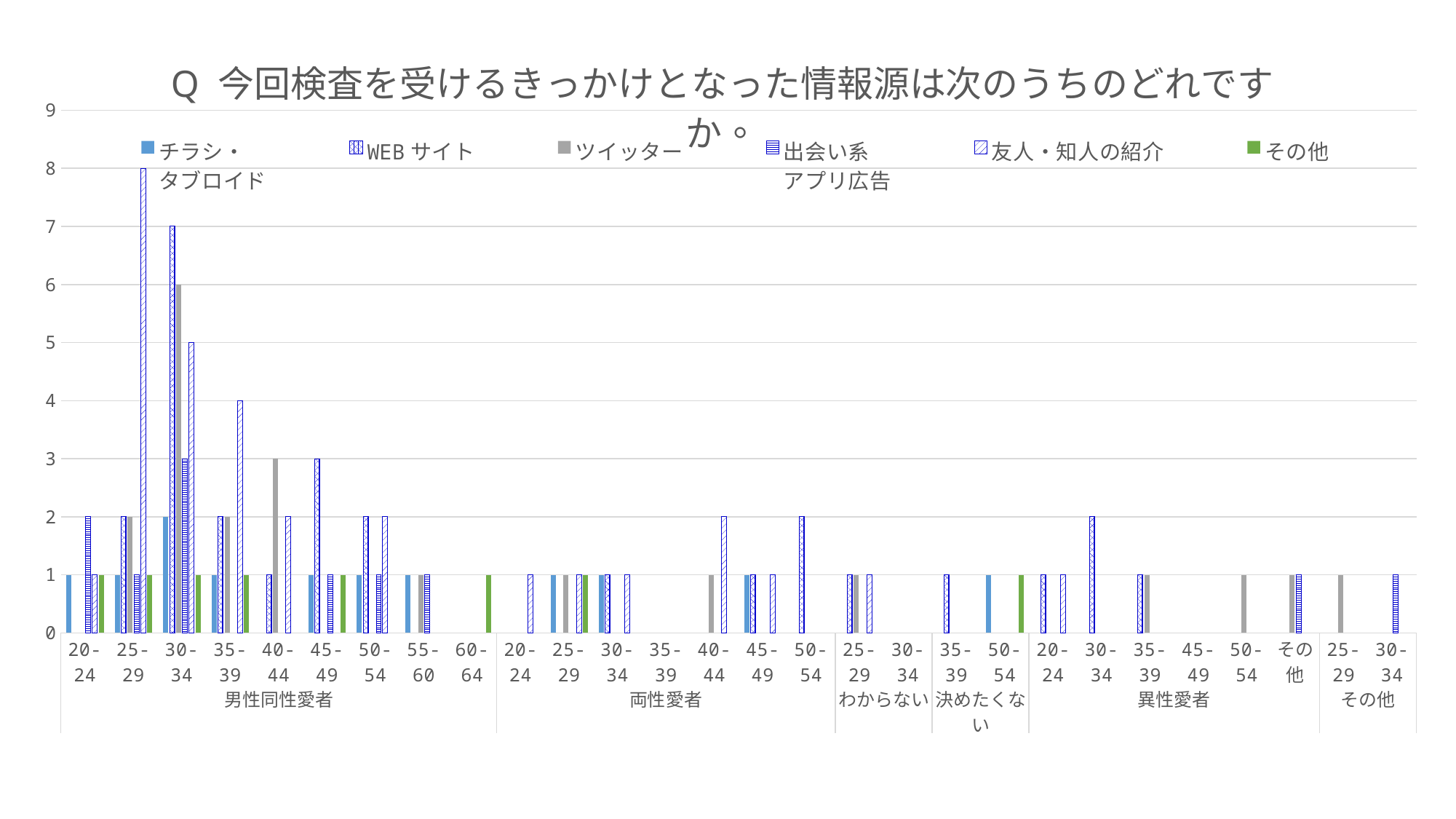
Is the value of 友人・知人の紹介 for 男性同性愛者 aged 25-29 greater or less than 6? greater What is the difference between 友人・知人の紹介 for 男性同性愛者 aged 25-29 and aged 30-34? 3 How many top-level groups (sexual orientation categories) are shown along the x axis? 6 What kind of chart is shown on the slide? bar chart Which age group within 男性同性愛者 contains the tallest bar in the chart? 25-29 What is the value of ツイッター for 男性同性愛者 aged 40-44? 3 What is the value of 友人・知人の紹介 for 男性同性愛者 aged 35-39? 4 How many series does the legend list? 6 For 男性同性愛者 aged 30-34, which is larger: WEBサイト or ツイッター? WEBサイト What is the value of 友人・知人の紹介 for 男性同性愛者 aged 25-29? 8 What is the value of ツイッター for 男性同性愛者 aged 30-34? 6 What is the value of WEBサイト for 男性同性愛者 aged 30-34? 7